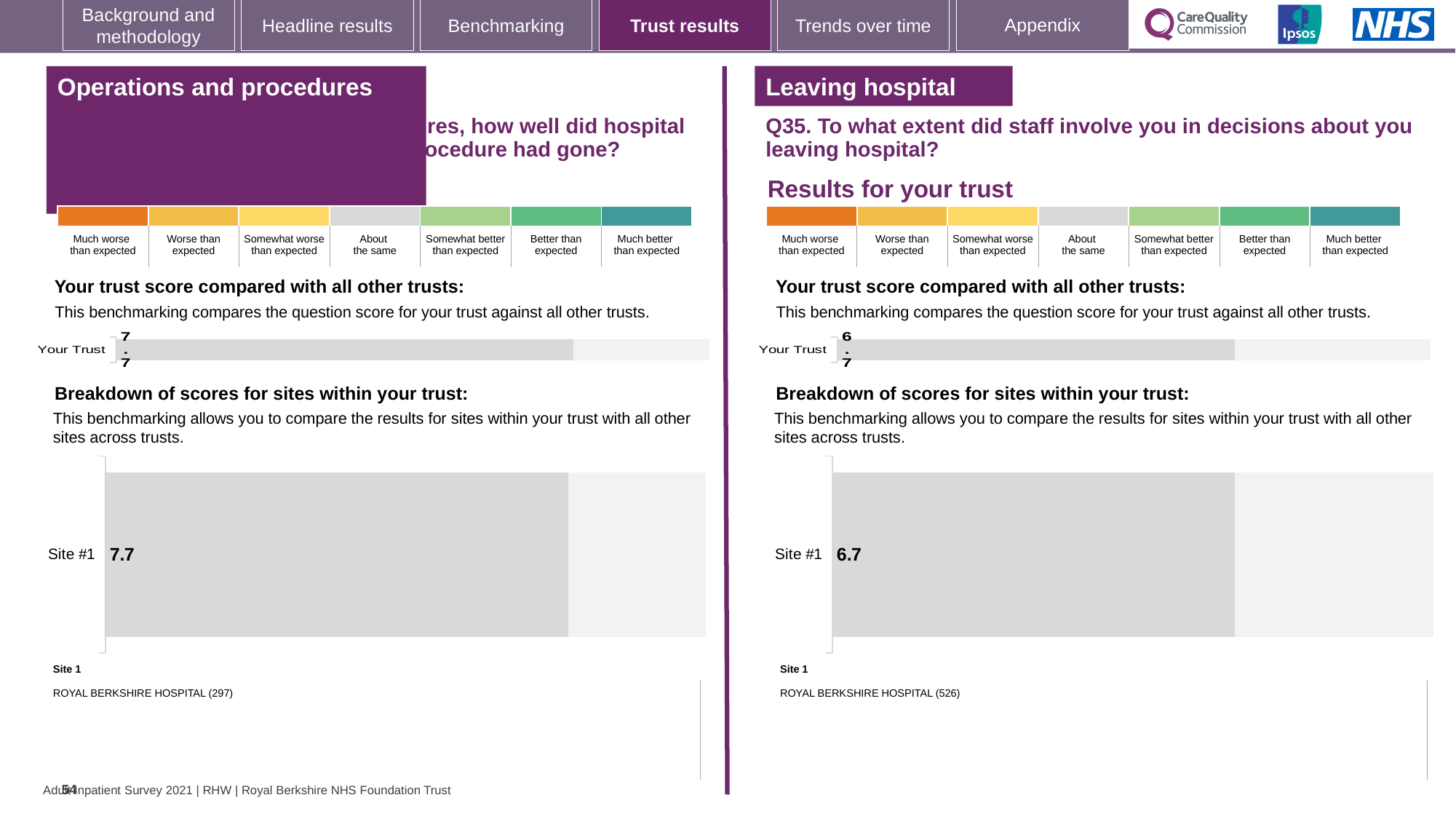
In the Operations and procedures section, what score is shown for Site #1 in the breakdown of scores for sites chart? 7.7 Which site name is listed as Site 1 below the Leaving hospital breakdown chart? ROYAL BERKSHIRE HOSPITAL (526) Which is larger: the Site #1 score in the Operations and procedures section or the Site #1 score in the Leaving hospital section? Operations and procedures Which site name is listed as Site 1 below the Operations and procedures breakdown chart? ROYAL BERKSHIRE HOSPITAL (297) How many sites are shown in the breakdown of scores for sites chart in the Leaving hospital section? 1 How many sites are shown in the breakdown of scores for sites chart in the Operations and procedures section? 1 In the Leaving hospital section, what is the score shown for Your Trust in the trust comparison bar chart? 6.7 In the Leaving hospital section, what score is shown for Site #1 in the breakdown of scores for sites chart? 6.7 What is the difference between the Site #1 score in the Operations and procedures section and the Site #1 score in the Leaving hospital section? 1.0 In the Operations and procedures section, what is the score shown for Your Trust in the trust comparison bar chart? 7.7 What type of chart is used to show the Site #1 score in the Leaving hospital section? Bar chart Is the Your Trust score in the Leaving hospital section greater or less than the Your Trust score in the Operations and procedures section? less